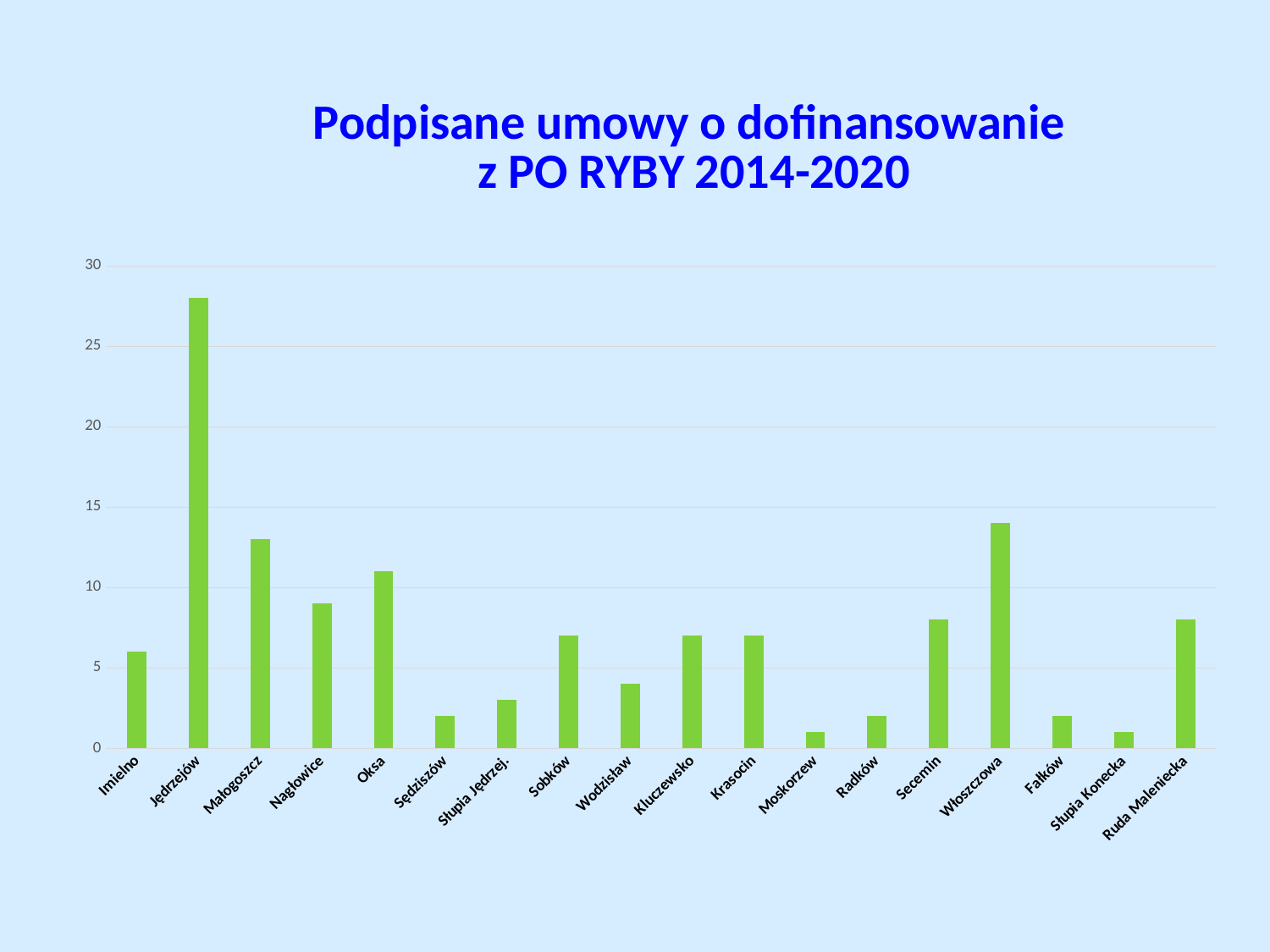
Which is larger, the value for Włoszczowa or the value for Secemin? Włoszczowa Which category has the highest value in the chart? Jędrzejów What colour are the bars in the chart? green Is the value for Sędziszów greater or less than 5? less What kind of chart is shown on the slide? bar chart What is the title of the chart? Podpisane umowy o dofinansowanie z PO RYBY 2014-2020 Is the value for Oksa greater or less than 10? greater Which is larger, the value for Nagłowice or the value for Wodzisław? Nagłowice How many categories are shown on the x axis of the chart? 18 Is the value for Jędrzejów greater or less than 25? greater